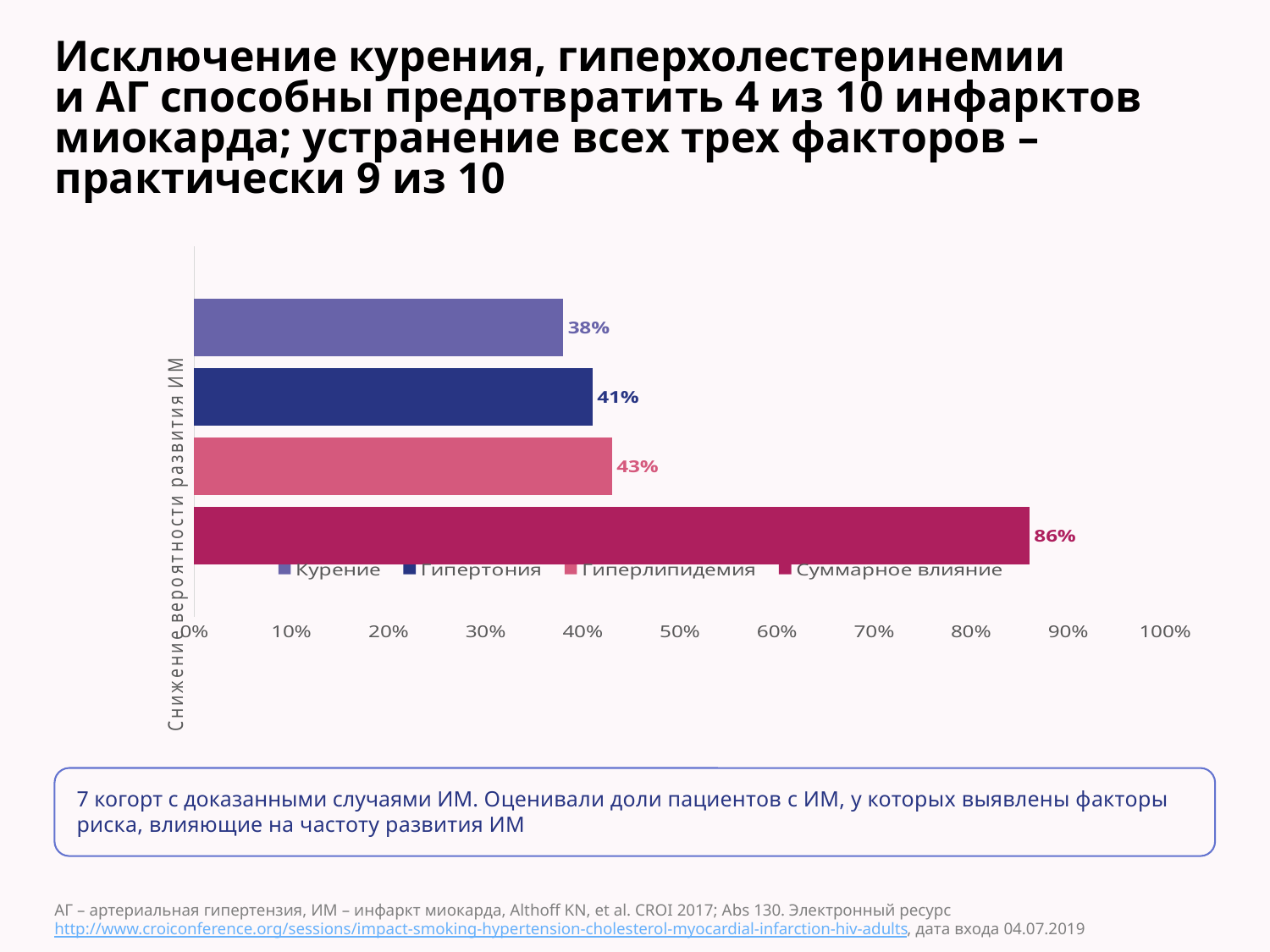
Which series has the lowest value? Курение What is the value shown for Курение? 38% What is the difference between the values for Суммарное влияние and Гиперлипидемия? 43% What is the label on the vertical axis of the chart? Снижение вероятности развития ИМ What kind of chart is shown on the slide? Bar chart What is the value shown for Гипертония? 41% Which is larger, the value for Гиперлипидемия or the value for Курение? Гиперлипидемия How many series does the legend list? 4 What is the value shown for Суммарное влияние? 86% Which series has the highest value? Суммарное влияние What is the difference between the values for Гипертония and Курение? 3% What is the value shown for Гиперлипидемия? 43%